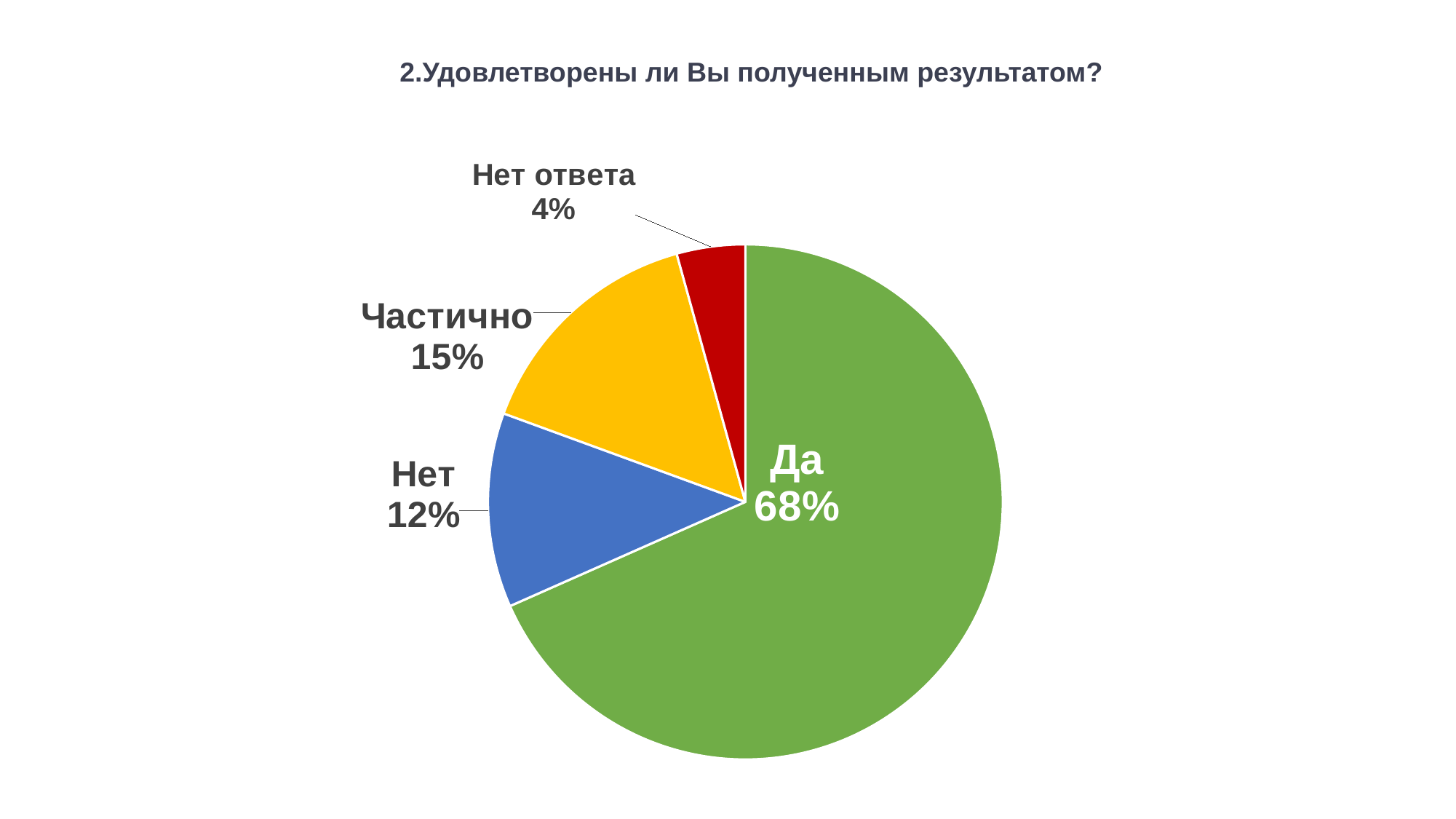
What is the difference in percentage points between "Да" and "Частично"? 53 What share of the pie does the "Да" slice represent? 68% Which is larger, the slice for "Нет" or the slice for "Нет ответа"? Нет What is the value shown for "Нет"? 12% What is the title of the chart? 2.Удовлетворены ли Вы полученным результатом? What is the value shown for "Частично"? 15% How many categories are shown in the pie chart? 4 What kind of chart is shown on the slide? Pie chart What is the difference in percentage points between "Частично" and "Нет"? 3 What is the value shown for "Нет ответа"? 4% Which category has the largest slice of the pie? Да Which category has the smallest slice of the pie? Нет ответа